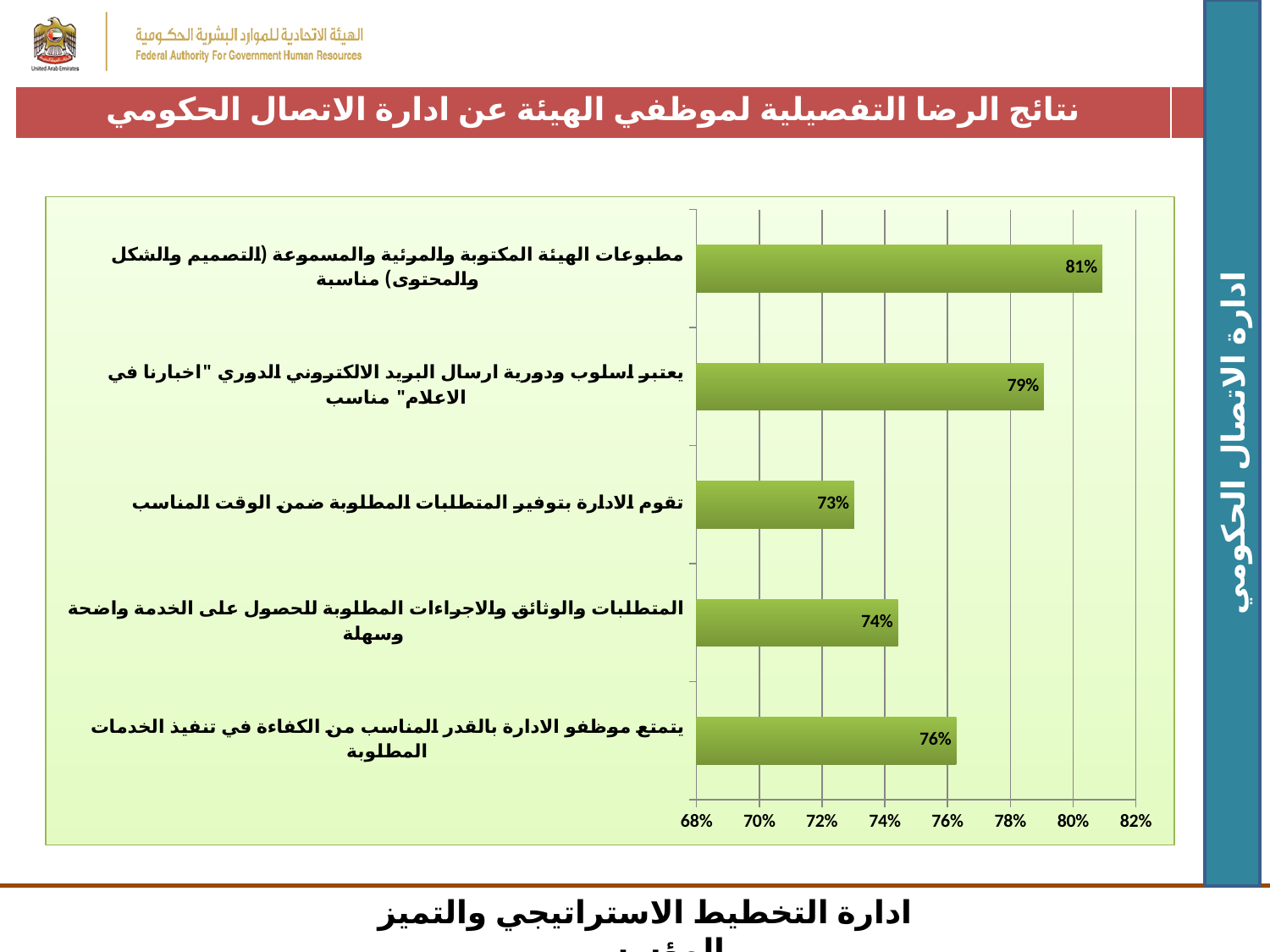
Is the value for "المتطلبات والوثائق والاجراءات المطلوبة للحصول على الخدمة واضحة وسهلة" greater or less than 78%? less What type of chart is shown on the slide? bar chart Which category has the highest value? مطبوعات الهيئة المكتوبة والمرئية والمسموعة (التصميم والشكل والمحتوى) مناسبة What is the value for "مطبوعات الهيئة المكتوبة والمرئية والمسموعة (التصميم والشكل والمحتوى) مناسبة"? 81% What is the value for "تقوم الادارة بتوفير المتطلبات المطلوبة ضمن الوقت المناسب"? 73% Which category has the lowest value? تقوم الادارة بتوفير المتطلبات المطلوبة ضمن الوقت المناسب How many categories are plotted in the chart? 5 What is the value for "يتمتع موظفو الادارة بالقدر المناسب من الكفاءة في تنفيذ الخدمات المطلوبة"? 76% Which is larger: the value for "يعتبر اسلوب ودورية ارسال البريد الالكتروني الدوري "اخبارنا في الاعلام" مناسب" or the value for "يتمتع موظفو الادارة بالقدر المناسب من الكفاءة في تنفيذ الخدمات المطلوبة"? يعتبر اسلوب ودورية ارسال البريد الالكتروني الدوري "اخبارنا في الاعلام" مناسب What is the title of the slide above the chart? نتائج الرضا التفصيلية لموظفي الهيئة عن ادارة الاتصال الحكومي What is the value for "المتطلبات والوثائق والاجراءات المطلوبة للحصول على الخدمة واضحة وسهلة"? 74% What is the difference between the value for "مطبوعات الهيئة المكتوبة والمرئية والمسموعة (التصميم والشكل والمحتوى) مناسبة" and the value for "تقوم الادارة بتوفير المتطلبات المطلوبة ضمن الوقت المناسب"? 8%